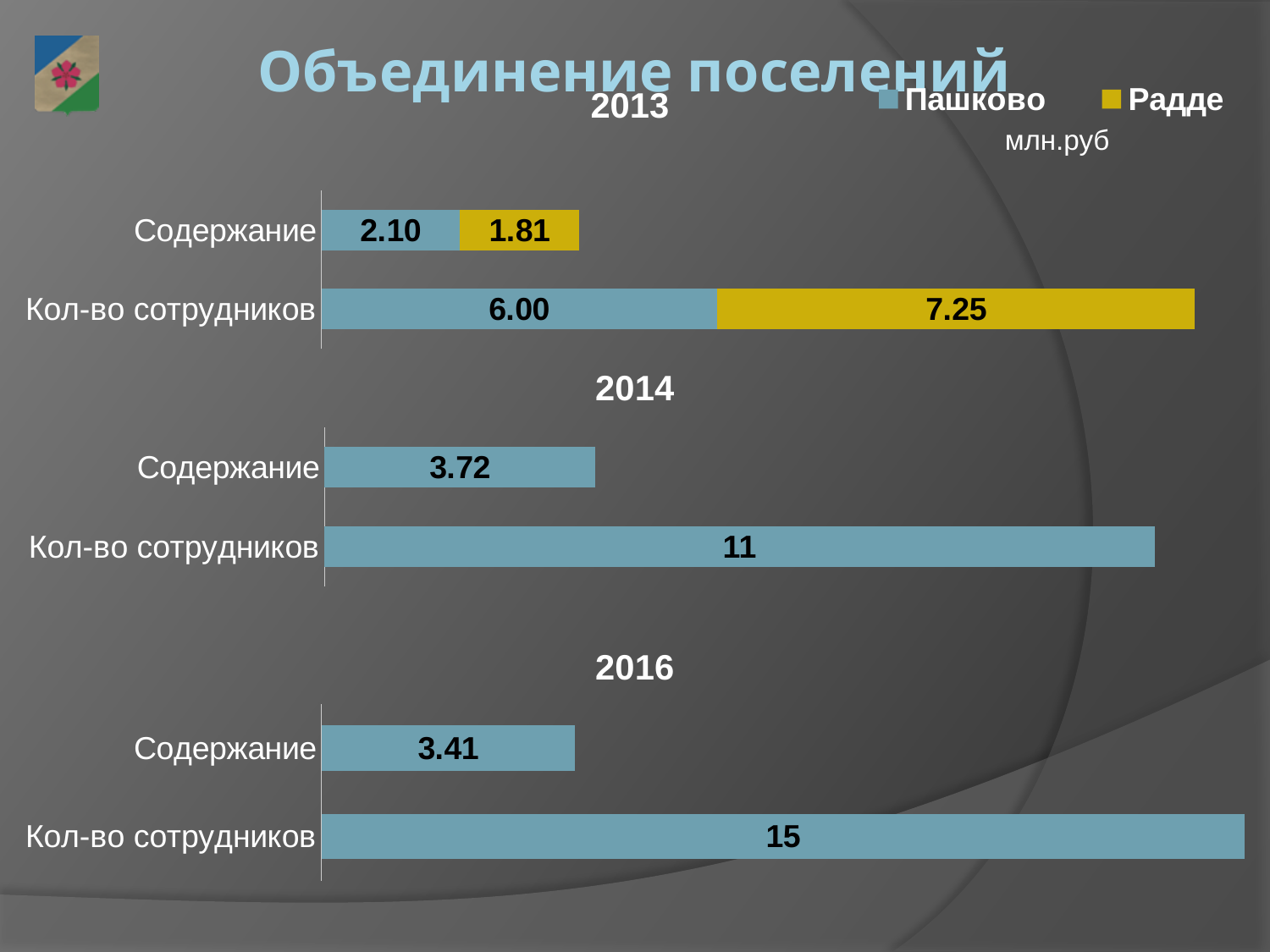
In the 2013 chart, what is the value for Радде in the Кол-во сотрудников bar? 7.25 In the 2013 chart, what is the total of the stacked Содержание bar? 3.91 In the 2013 chart, what is the difference between Пашково and Радде for Содержание? 0.29 How many series does the legend list? 2 In the 2013 chart, what is the value for Пашково in the Содержание bar? 2.10 In the 2013 chart, what is the total of the stacked Кол-во сотрудников bar? 13.25 What is the difference in Кол-во сотрудников between the 2016 chart and the 2014 chart? 4 In the 2014 chart, what is the value for Кол-во сотрудников? 11 What kind of chart is the 2016 chart? bar chart In the 2013 chart, which is larger for Кол-во сотрудников: Пашково or Радде? Радде In the 2014 chart, what is the value for Содержание? 3.72 In the 2016 chart, what is the value for Кол-во сотрудников? 15